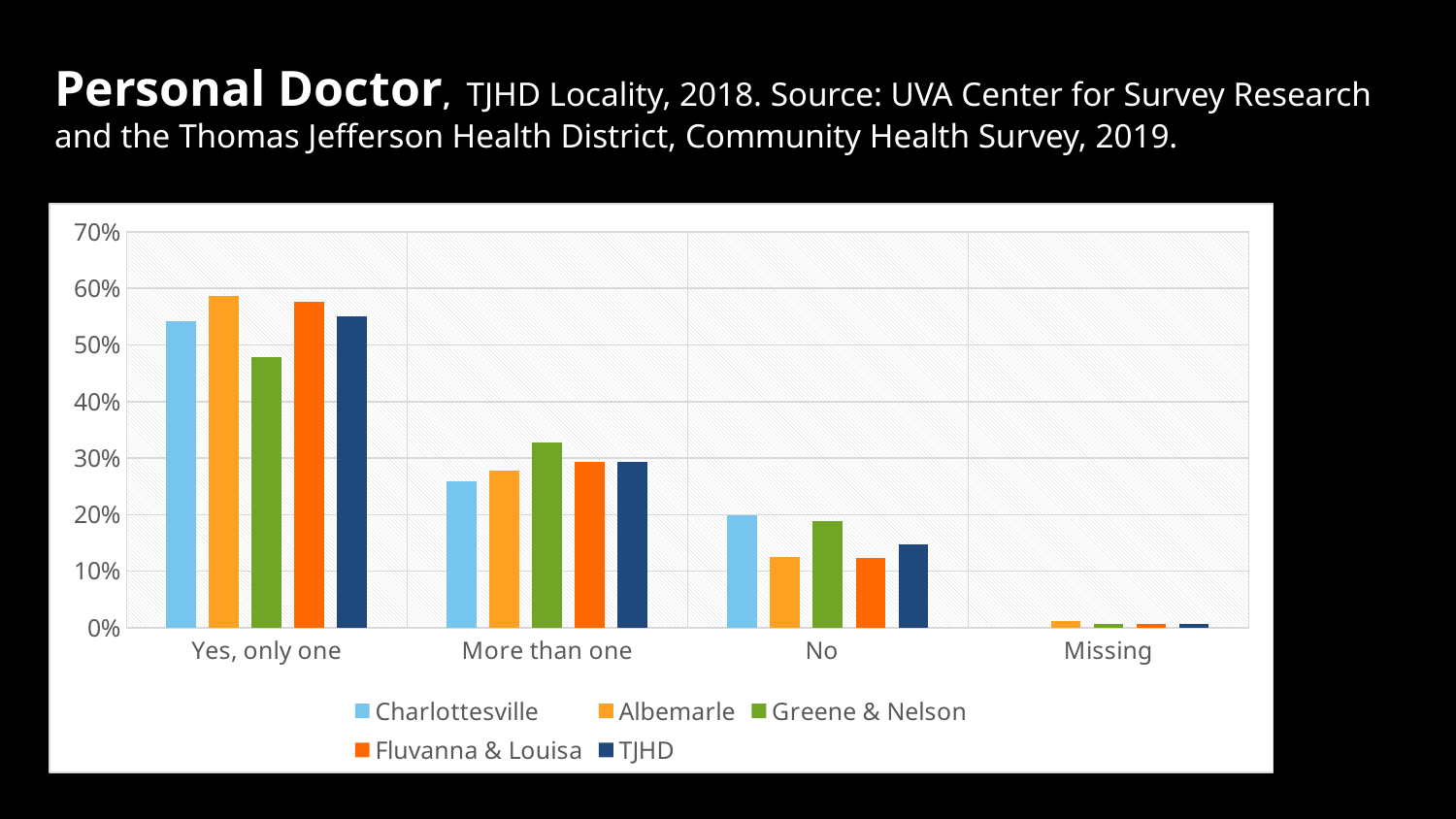
Which locality has the lowest value for "Yes, only one"? Greene & Nelson Which locality has the highest value for "More than one"? Greene & Nelson How many series does the legend list? 5 For the "No" category, which is larger: Charlottesville or Albemarle? Charlottesville Which series is shown in dark blue in the legend? TJHD Is the value for Albemarle in "No" greater or less than 20%? less Which locality has the lowest value for "More than one"? Charlottesville How many response categories are shown on the x axis? 4 Is the value for Greene & Nelson in "More than one" greater or less than 30%? greater What type of chart is shown on the slide? bar chart Is the value for Charlottesville in "Yes, only one" greater or less than 50%? greater